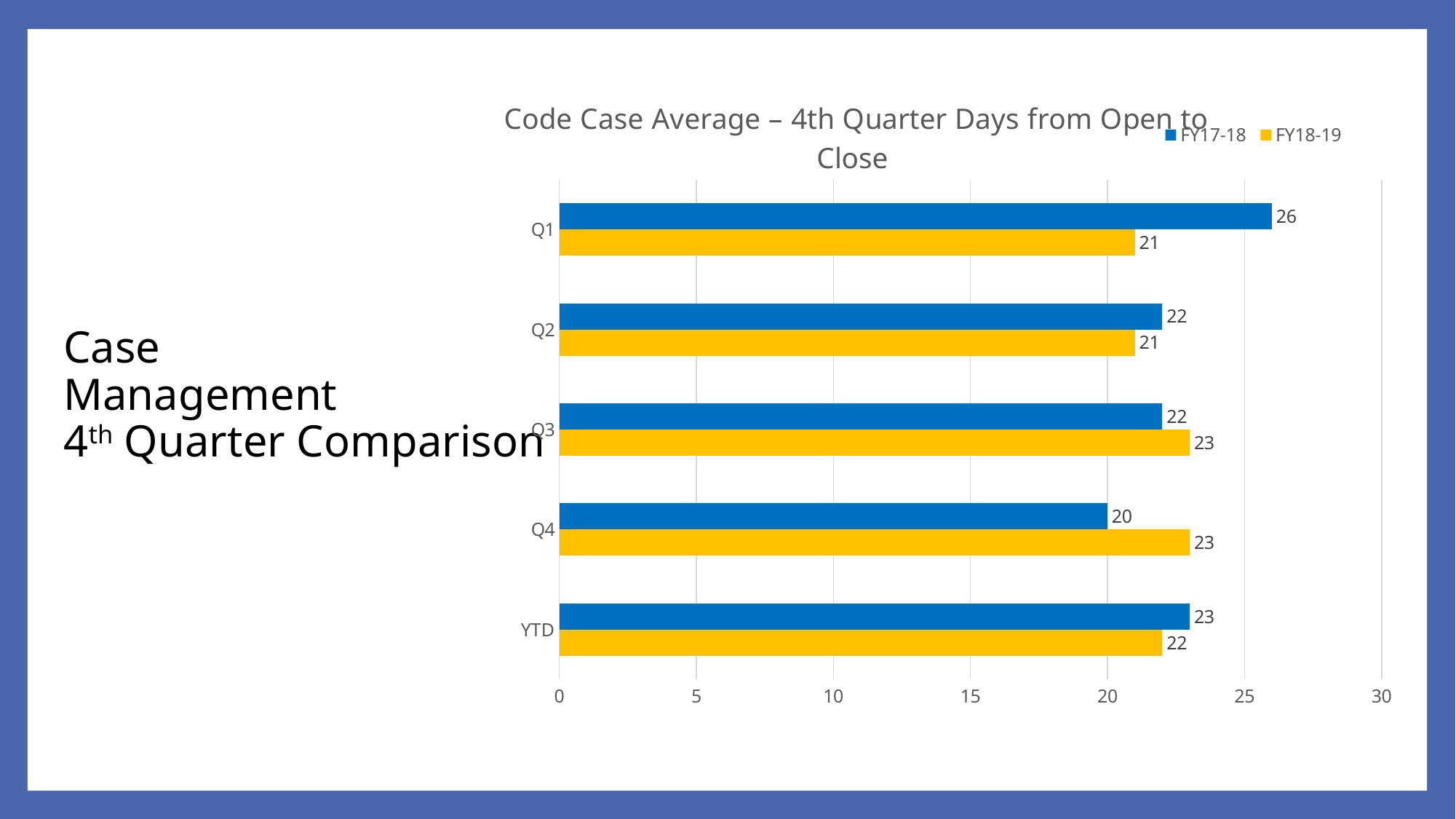
Which colour represents the FY18-19 series? Yellow How many categories are shown on the chart? 5 What kind of chart is shown on the slide? Bar chart Which is larger for Q3, the FY17-18 value or the FY18-19 value? FY18-19 Which category has the highest FY17-18 value? Q1 Which category has the lowest FY17-18 value? Q4 What is the difference between the FY17-18 and FY18-19 values for Q1? 5 What is the FY18-19 value for Q4? 23 What is the FY18-19 value for YTD? 22 What is the FY17-18 value for Q1? 26 What is the difference between the FY18-19 and FY17-18 values for Q4? 3 How many series does the legend list? 2